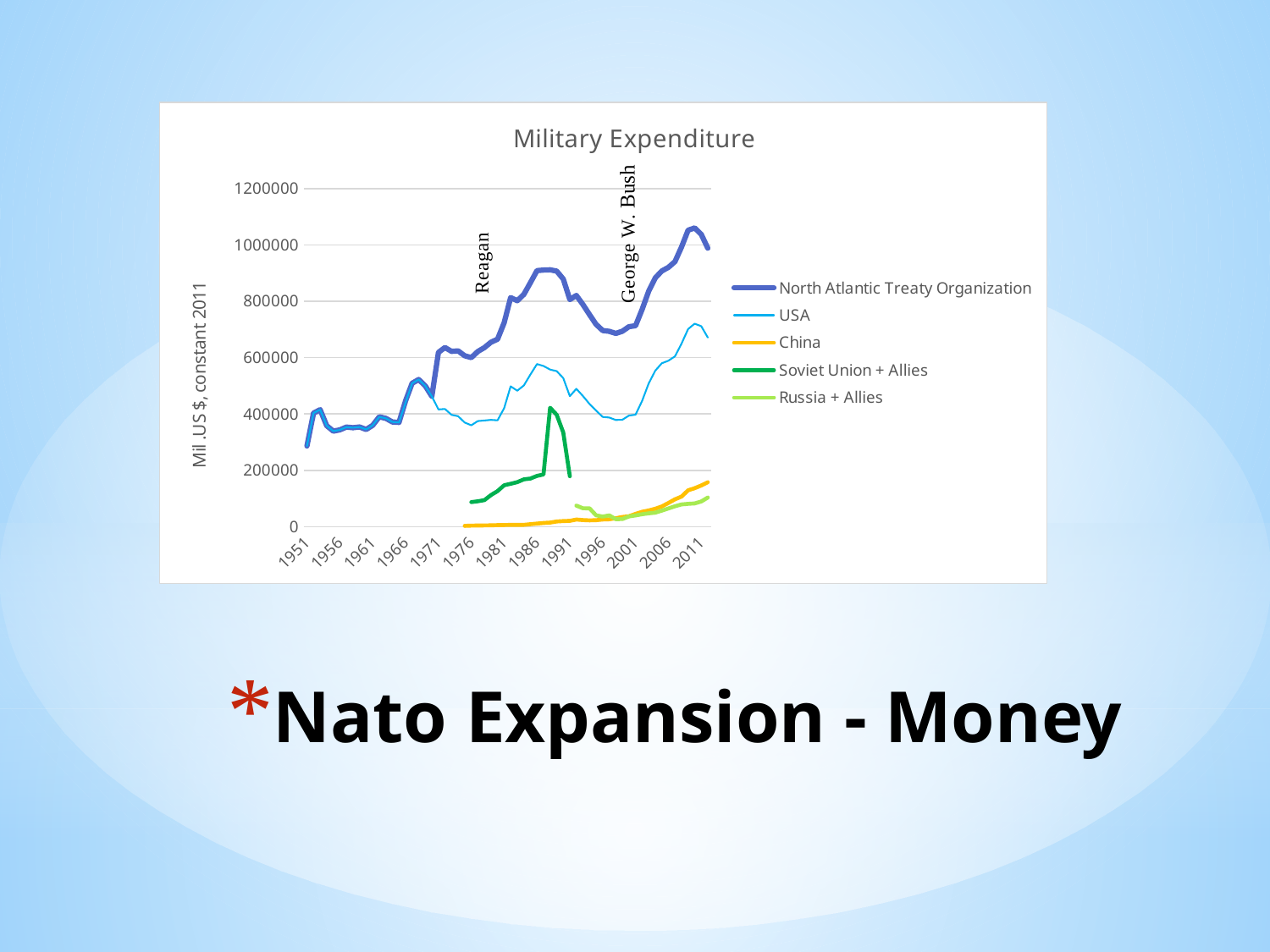
Is the value for North Atlantic Treaty Organization in 2011 greater or less than 800000? greater Which series has the highest values across the chart? North Atlantic Treaty Organization How many series does the legend list? 5 Is the value for USA in 2011 greater or less than 600000? greater Which is larger in 2011, the value for North Atlantic Treaty Organization or the value for USA? North Atlantic Treaty Organization What is the title of the chart? Military Expenditure What kind of chart is shown on the slide? Line chart Does the North Atlantic Treaty Organization series generally rise or fall from 1951 to 2011? Rise What is the label on the vertical axis of the chart? Mil .US $, constant 2011 Is the value for North Atlantic Treaty Organization in 1951 greater or less than 400000? less Which is larger in 2011, the value for China or the value for Russia + Allies? China